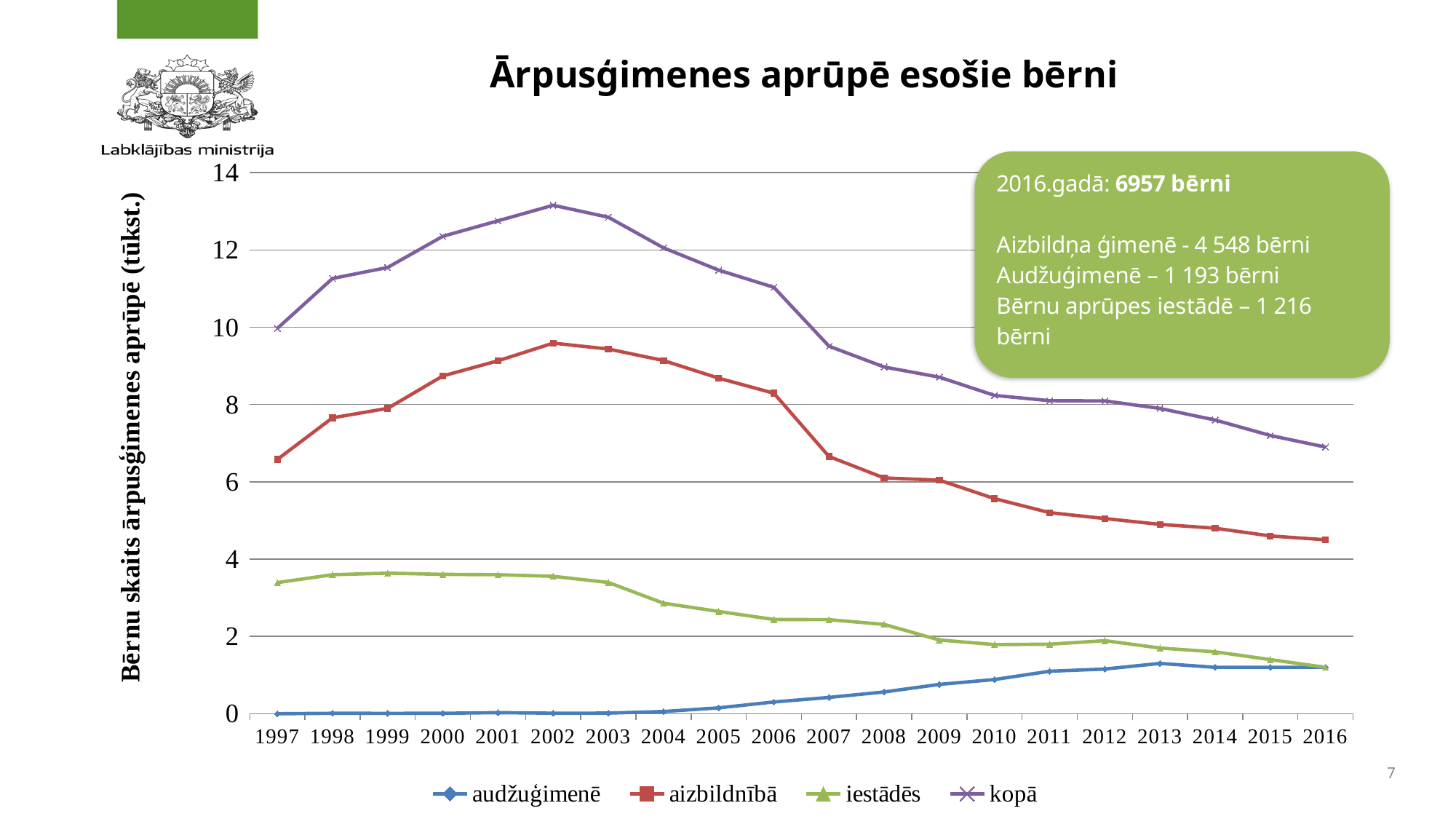
According to the text box on the slide, how many children were in out-of-family care in 2016? 6957 bērni In which year does the kopā series reach its highest value? 2002 How many series does the chart legend list? 4 How many years are plotted along the x axis of the chart? 20 Is the value of the kopā series in 2002 greater or less than 12? greater Is the value of the iestādēs series in 2004 greater or less than 2? greater Does the audžuģimenē series rise or fall from 1997 to 2016? rise What kind of chart is shown on the slide? line chart Is the value of the aizbildnībā series in 1997 greater or less than 8? less In 2005, which series has the larger value: aizbildnībā or iestādēs? aizbildnībā In which year is the kopā series at its lowest value? 2016